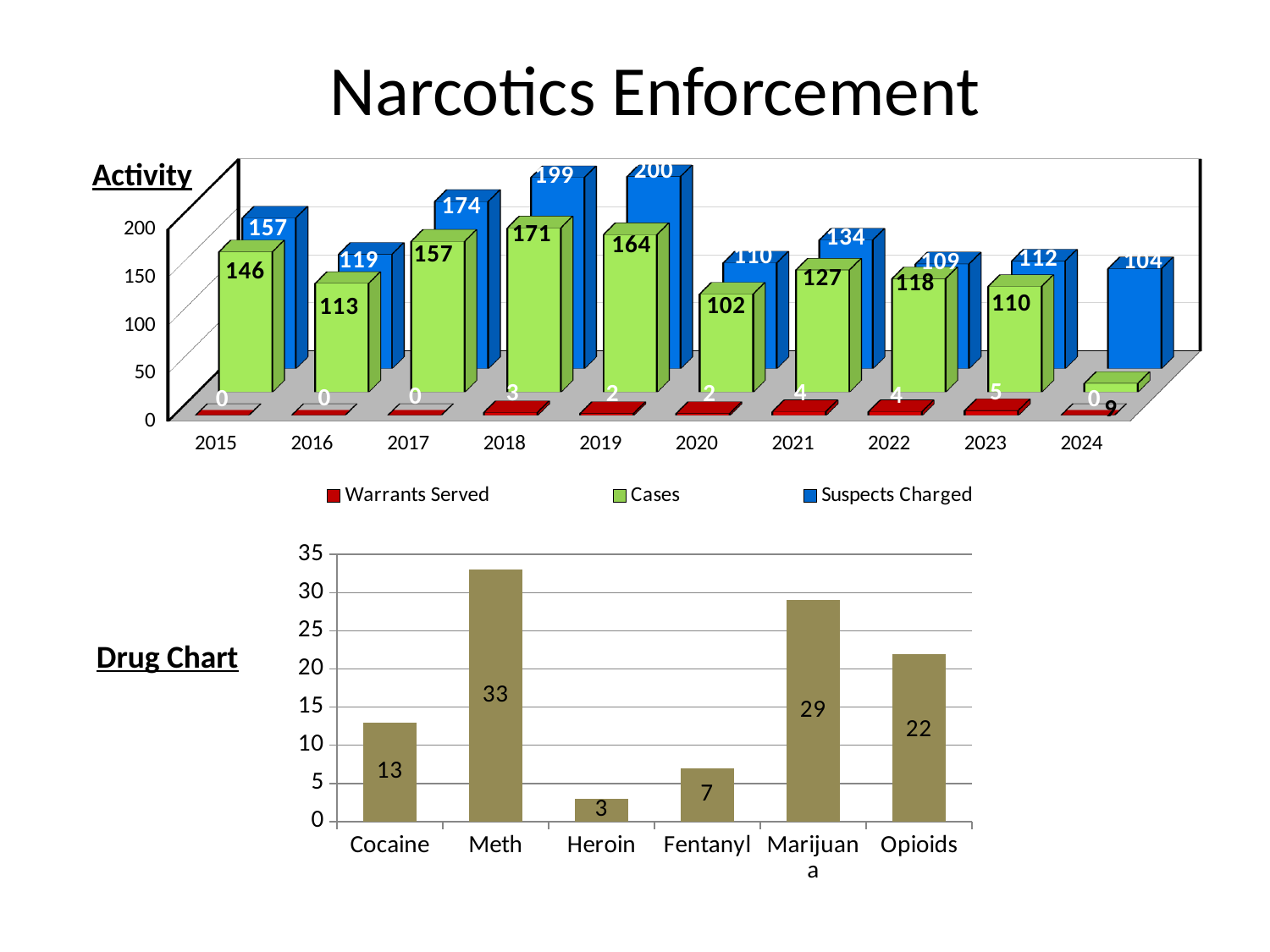
In the Activity chart, how many Warrants Served were there in 2023? 5 In the Drug Chart, which drug has the lowest value? Heroin What kind of chart is the Drug Chart? Bar chart In the Drug Chart, what is the difference between the values for Marijuana and Opioids? 7 In the Activity chart, what is the difference between Suspects Charged and Cases in 2018? 28 In the Activity chart, which year had the highest number of Suspects Charged? 2019 In the Drug Chart, what is the value for Meth? 33 How many series does the legend of the Activity chart list? 3 In the Activity chart, how many Cases were there in 2018? 171 In the Activity chart, how many Suspects Charged were there in 2019? 200 How many categories are shown in the Drug Chart? 6 In the Activity chart, were there more Cases in 2017 or in 2020? 2017